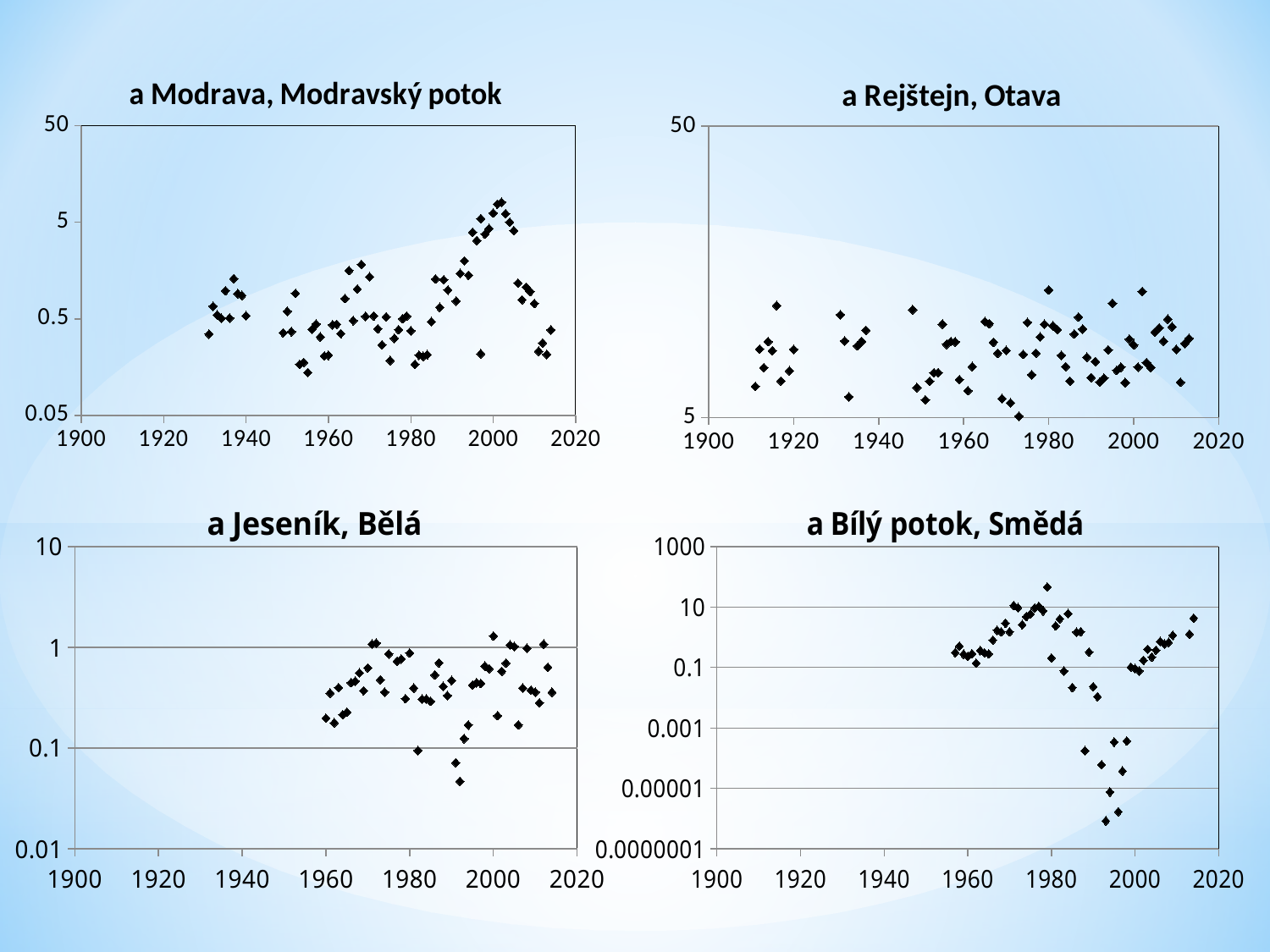
In 'a Jeseník, Bělá', is the highest plotted value greater or less than 1? greater What kind of chart is 'a Modrava, Modravský potok'? scatter chart In 'a Rejštejn, Otava', is the highest plotted value greater or less than 50? less How many charts are shown on the slide? 4 In 'a Bílý potok, Smědá', do the values rise or fall between 1980 and 1995? fall In 'a Bílý potok, Smědá', is the lowest plotted value greater or less than 0.00001? less What is the title of the bottom-left chart? a Jeseník, Bělá In 'a Modrava, Modravský potok', do the values rise or fall between 1990 and 2001? rise In 'a Modrava, Modravský potok', which is larger: the value around 2001 or the value around 1955? the value around 2001